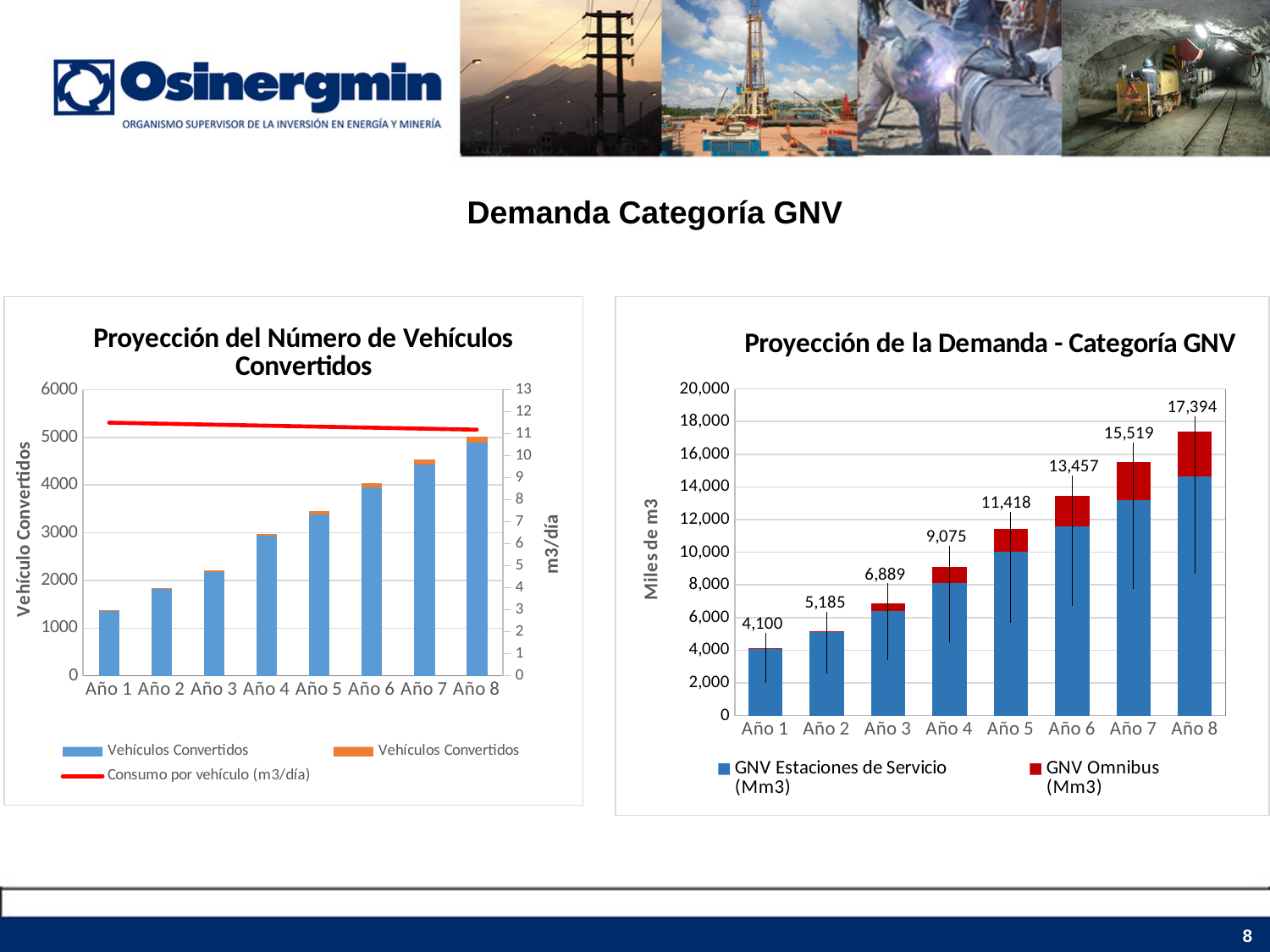
In the chart 'Proyección del Número de Vehículos Convertidos', how many years are shown on the x axis? 8 In the chart 'Proyección de la Demanda - Categoría GNV', which is larger: the total for Año 3 or the total for Año 4? Año 4 In the chart 'Proyección de la Demanda - Categoría GNV', what is the difference between the total for Año 8 and the total for Año 1? 13,294 In the chart 'Proyección de la Demanda - Categoría GNV', which year has the highest total demand? Año 8 In the chart 'Proyección del Número de Vehículos Convertidos', is the bar for Año 7 greater or less than 4000 vehicles? greater In the chart 'Proyección de la Demanda - Categoría GNV', which year has the lowest total demand? Año 1 In the chart 'Proyección de la Demanda - Categoría GNV', do the total values rise or fall from Año 1 to Año 8? rise In the chart 'Proyección del Número de Vehículos Convertidos', is the bar for Año 1 greater or less than 2000 vehicles? less In the chart 'Proyección de la Demanda - Categoría GNV', what is the total value labelled for Año 1? 4,100 In the chart 'Proyección de la Demanda - Categoría GNV', what is the total value labelled for Año 5? 11,418 In the chart 'Proyección de la Demanda - Categoría GNV', how many series does the legend list? 2 In the chart 'Proyección de la Demanda - Categoría GNV', what is the difference between the totals for Año 5 and Año 4? 2,343